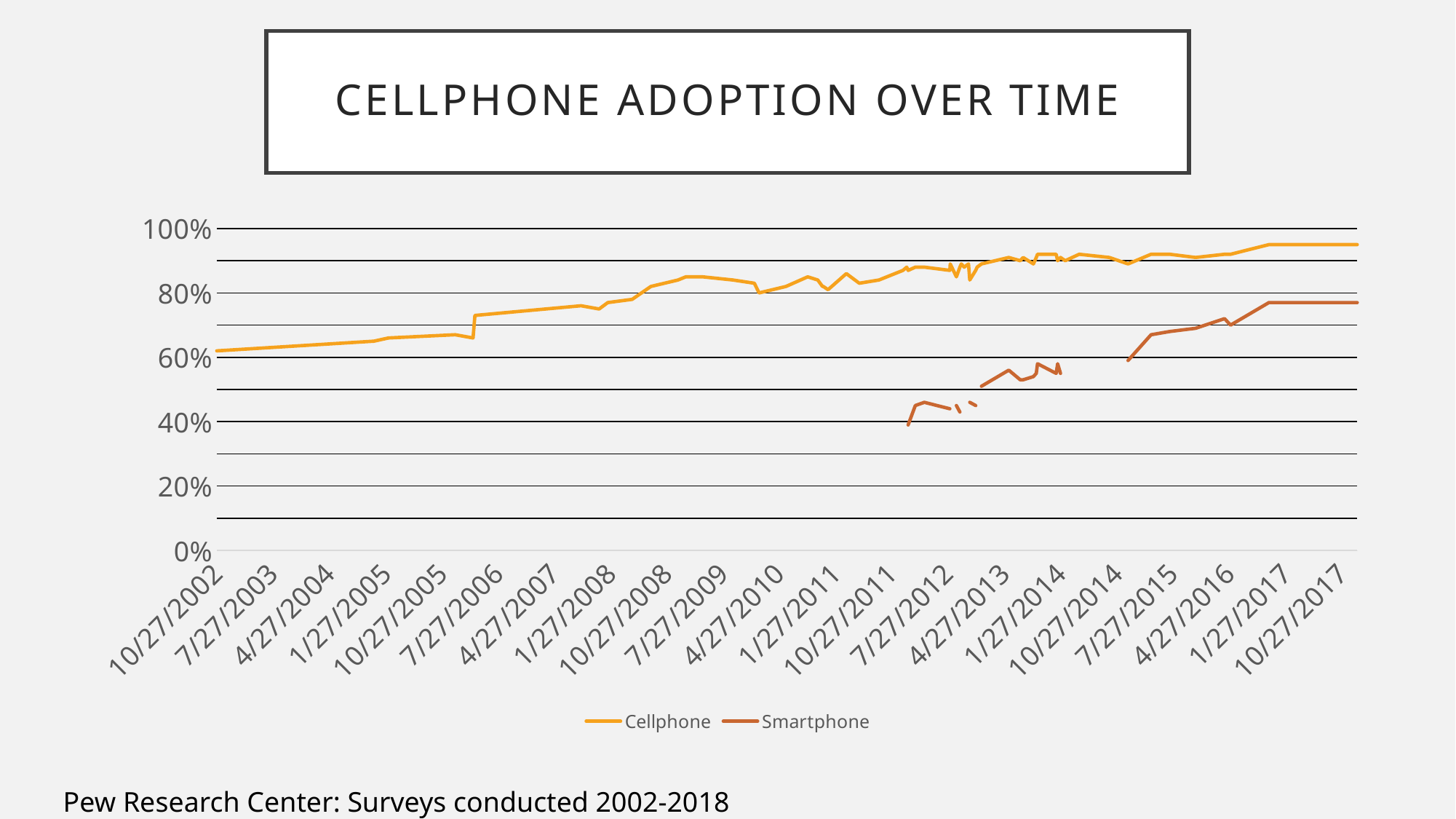
Is the Smartphone value at 10/27/2017 greater or less than 80%? less Is the Smartphone value at 1/27/2014 greater or less than 50%? greater How many series does the legend list? 2 Which series reaches the highest value on the chart? Cellphone What kind of chart is shown on the slide? line chart Which series is higher at 10/27/2017, Cellphone or Smartphone? Cellphone Is the Cellphone value at 10/27/2017 greater or less than 90%? greater Does the Cellphone line generally rise or fall from 10/27/2002 to 10/27/2017? rise What is the title of the chart? CELLPHONE ADOPTION OVER TIME Does the Smartphone line generally rise or fall over the period it is plotted? rise Which two series are listed in the legend? Cellphone and Smartphone